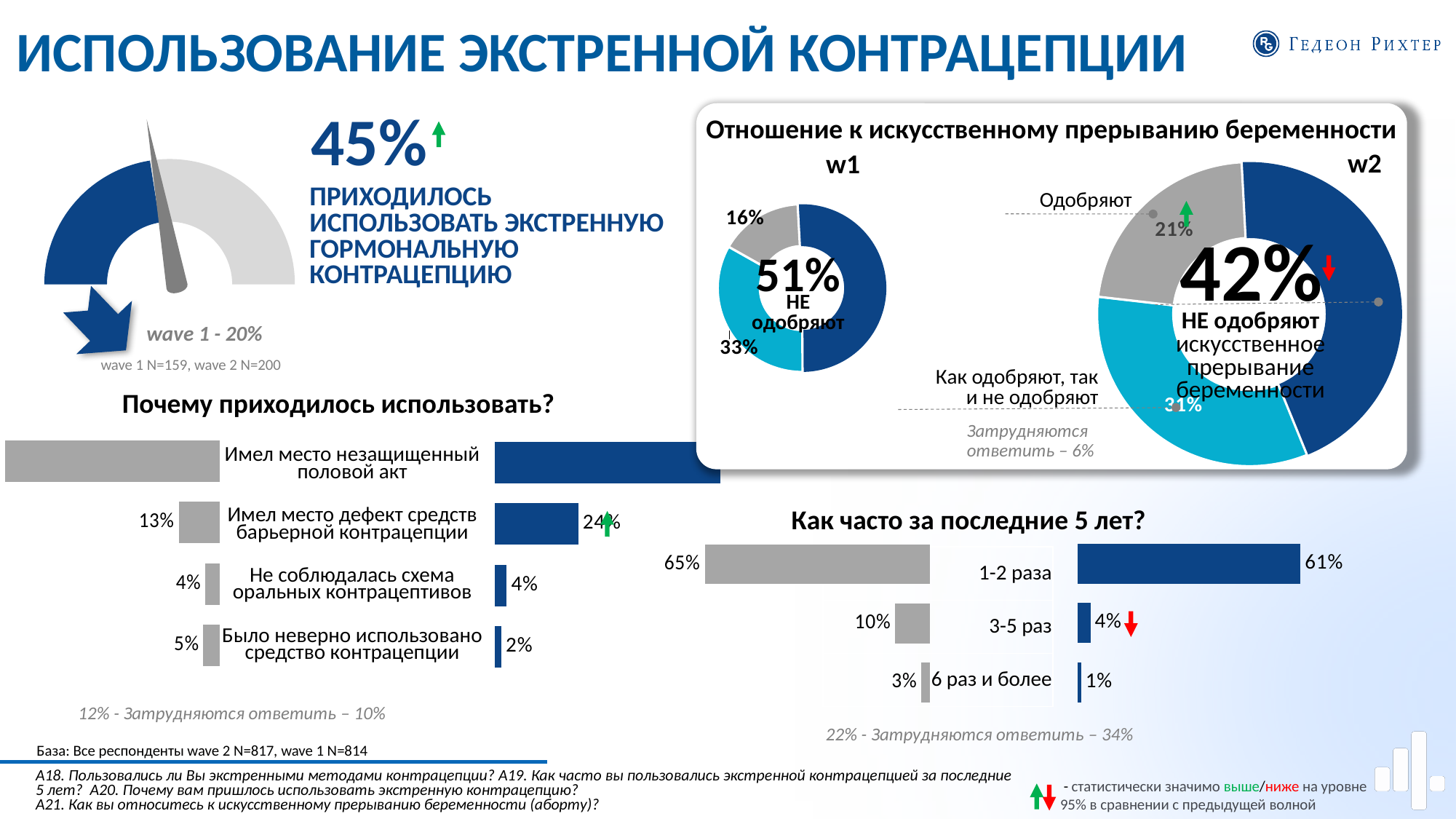
On the 'Как часто за последние 5 лет?' chart, which category has the highest value among the blue bars? 1-2 раза On the 'Как часто за последние 5 лет?' chart, what is the value of the grey bar for '1-2 раза'? 65% On the gauge chart at the top left, what percentage had to use emergency hormonal contraception in wave 1? 20% On the 'Как часто за последние 5 лет?' chart, which category has the lowest value among the grey bars? 6 раз и более On the 'Почему приходилось использовать?' chart, how many categories are shown? 4 On the 'Как часто за последние 5 лет?' chart, what is the difference between the grey and blue bars for '3-5 раз'? 6% On the 'Почему приходилось использовать?' chart, which is larger for 'Было неверно использовано средство контрацепции': the grey bar or the blue bar? grey bar On the 'Почему приходилось использовать?' chart, what is the value of the blue bar for 'Имел место дефект средств барьерной контрацепции'? 24% On the 'Отношение к искусственному прерыванию беременности' w1 donut chart, what share of respondents 'НЕ одобряют'? 51% On the 'Как часто за последние 5 лет?' chart, what is the value of the blue bar for '3-5 раз'? 4% On the 'Отношение к искусственному прерыванию беременности' w2 donut chart, what share of respondents 'Одобряют'? 21% What kind of chart is used for 'Как часто за последние 5 лет?'? bar chart